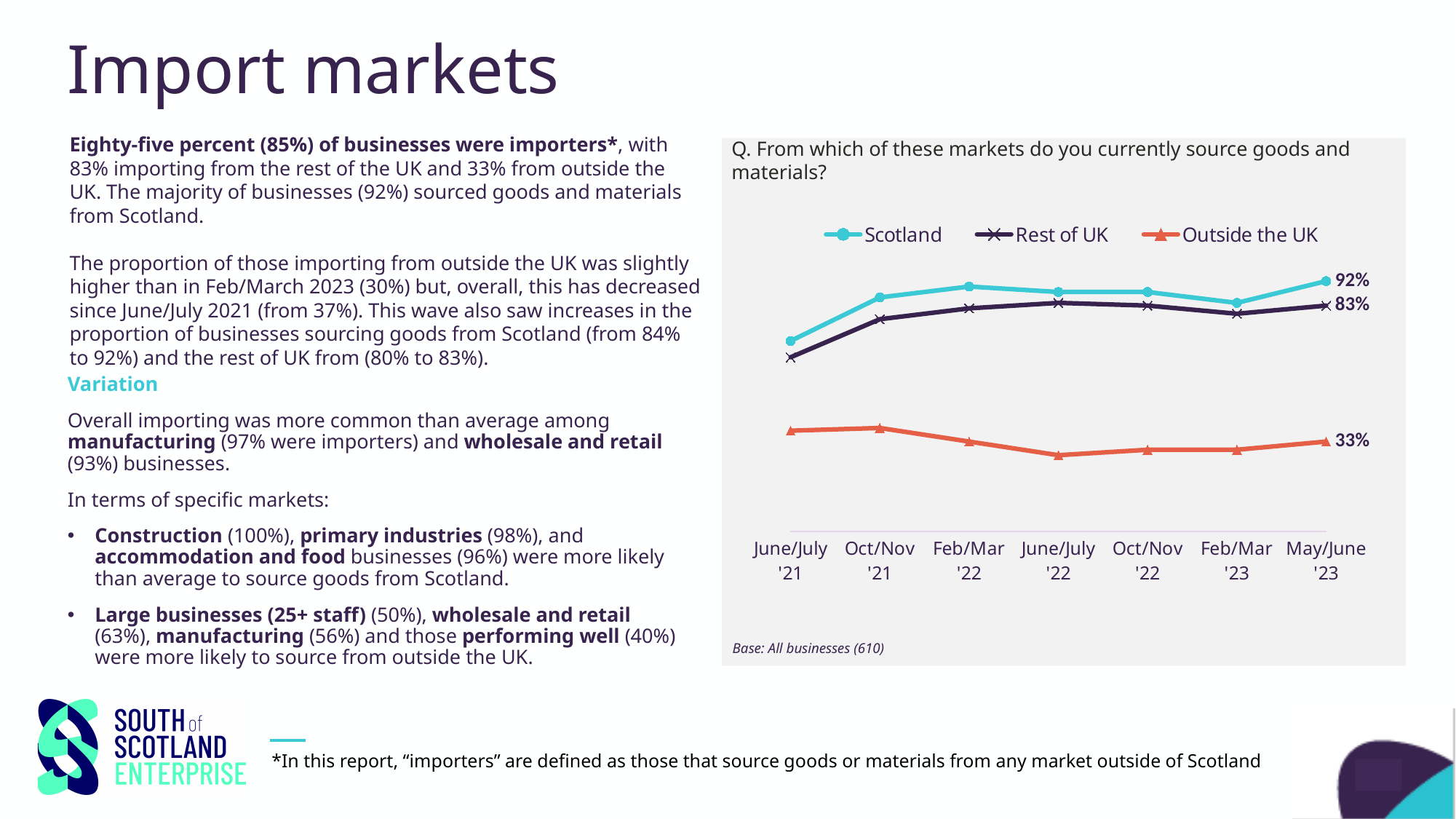
What is the value for Outside the UK at May/June '23? 33% At May/June '23, which is larger: the value for Rest of UK or the value for Outside the UK? Rest of UK What kind of chart is shown on the slide? Line chart What is the value for Rest of UK at May/June '23? 83% How many series does the legend list? 3 Which series has the highest value at May/June '23? Scotland Does the Scotland series rise or fall overall from June/July '21 to May/June '23? Rise What is the difference between the Scotland and Rest of UK values at May/June '23? 9 percentage points What is the base stated below the chart? All businesses (610) What is the value for Scotland at May/June '23? 92% Which series has the lowest value at May/June '23? Outside the UK How many time points are shown on the x axis? 7